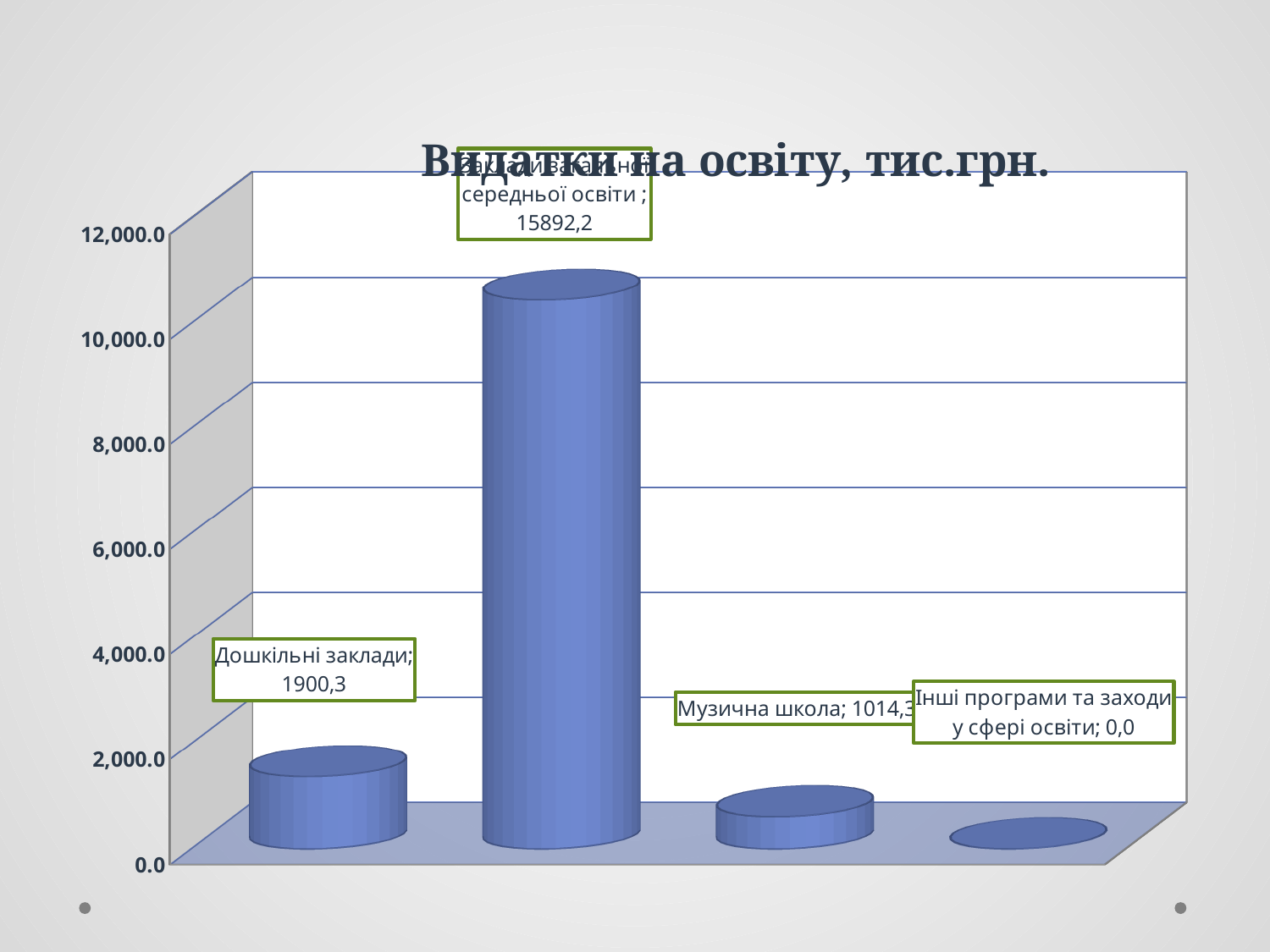
What is the value for Заклади загальної середньої освіти? 15892,2 What is the value for Інші програми та заходи у сфері освіти? 0,0 Which category has the highest value? Заклади загальної середньої освіти What is the difference between the values for Дошкільні заклади and Музична школа? 886,0 Which category has the lowest value? Інші програми та заходи у сфері освіти How many categories are shown in the chart? 4 What kind of chart is shown on the slide? bar chart What is the title of the chart? Видатки на освіту, тис.грн. Is the value for Музична школа greater or less than 2,000.0? less Which is larger, the value for Дошкільні заклади or the value for Музична школа? Дошкільні заклади What is the value for Музична школа? 1014,3 What is the value for Дошкільні заклади? 1900,3